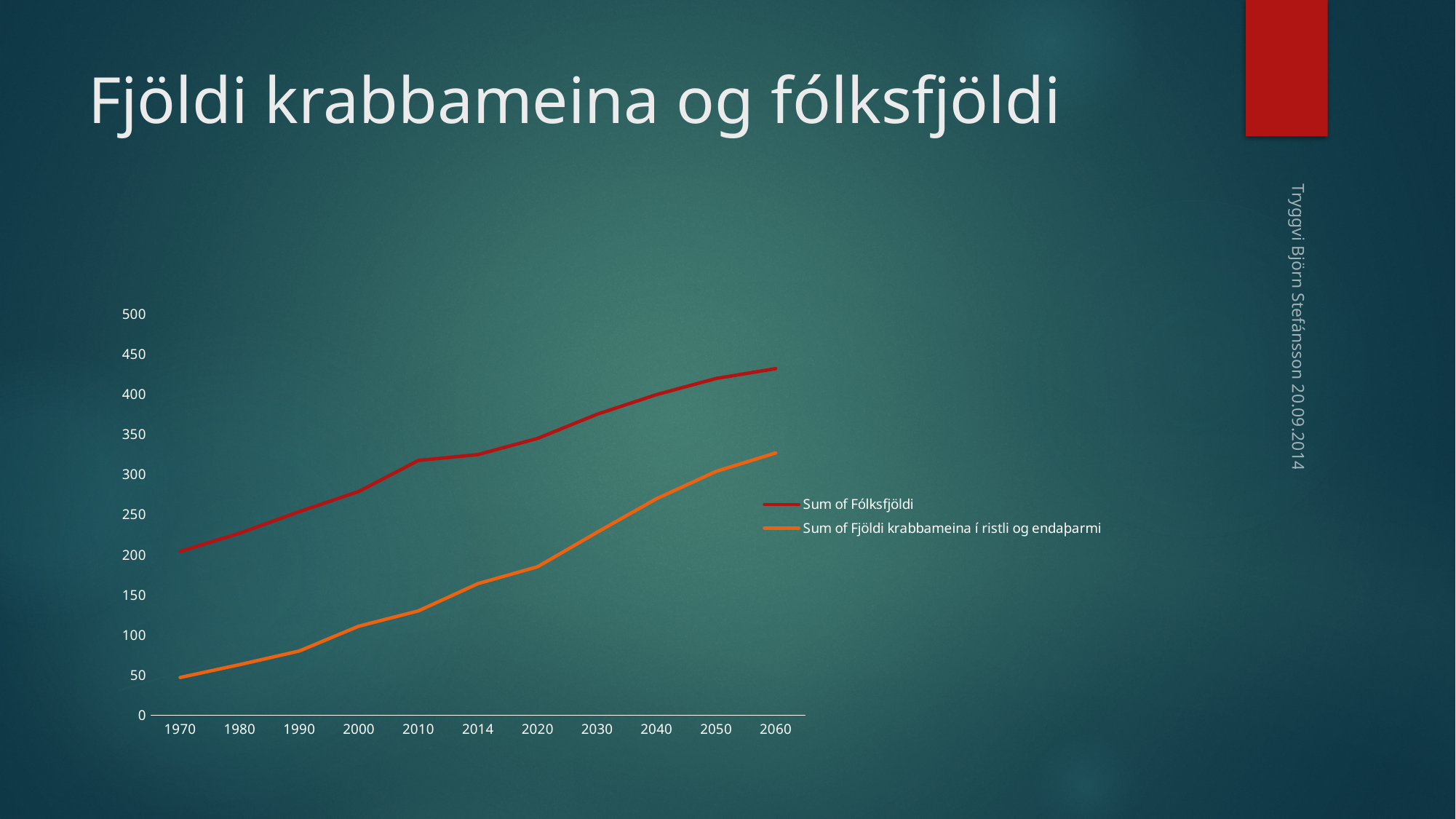
In which year is the value for Sum of Fjöldi krabbameina í ristli og endaþarmi lowest? 1970 How many years are shown on the x axis? 11 What is the title of the slide containing the chart? Fjöldi krabbameina og fólksfjöldi Do the values for Sum of Fólksfjöldi rise or fall from 1970 to 2060? rise Is the value for Sum of Fólksfjöldi in 2060 greater or less than 400? greater Is the value for Sum of Fólksfjöldi in 2010 greater or less than 300? greater How many series does the legend list? 2 In 2000, which series has the larger value, Sum of Fólksfjöldi or Sum of Fjöldi krabbameina í ristli og endaþarmi? Sum of Fólksfjöldi Do the values for Sum of Fjöldi krabbameina í ristli og endaþarmi rise or fall along the x axis? rise What kind of chart is shown on the slide? line chart Is the value for Sum of Fjöldi krabbameina í ristli og endaþarmi in 2060 greater or less than 300? greater